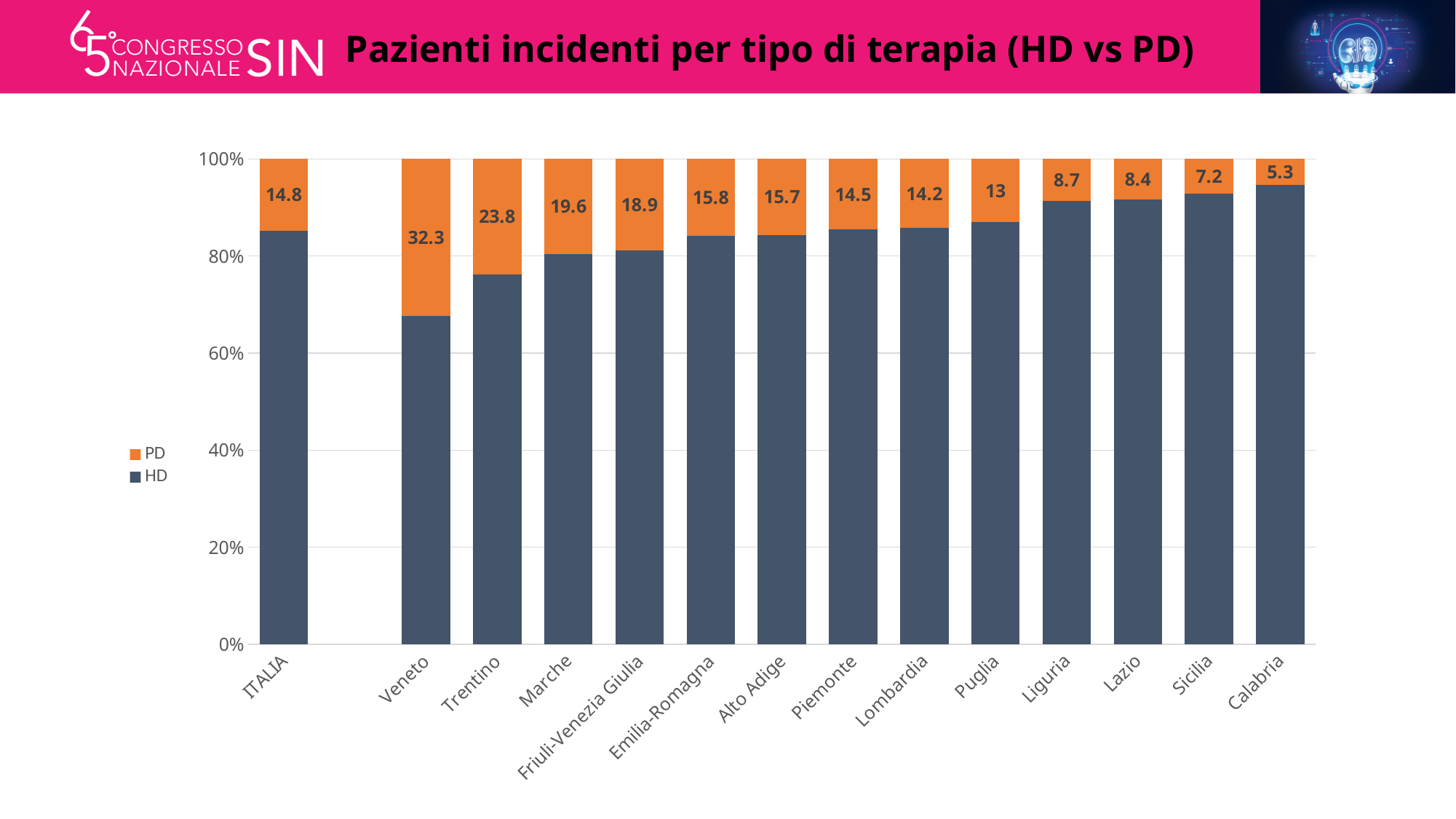
What is the PD value for Veneto? 32.3 Which region has the lowest PD value? Calabria Is the HD share for Calabria greater or less than 80%? greater Is the HD share for Veneto greater or less than 80%? less How many series does the legend list? 2 What is the PD value for ITALIA? 14.8 Which has a larger PD value, Marche or Friuli-Venezia Giulia? Marche What is the PD value for Calabria? 5.3 Which region has the highest PD value? Veneto What kind of chart is shown on the slide? Stacked bar chart How many categories are shown on the x axis? 14 What is the difference between the PD values for Veneto and Trentino? 8.5